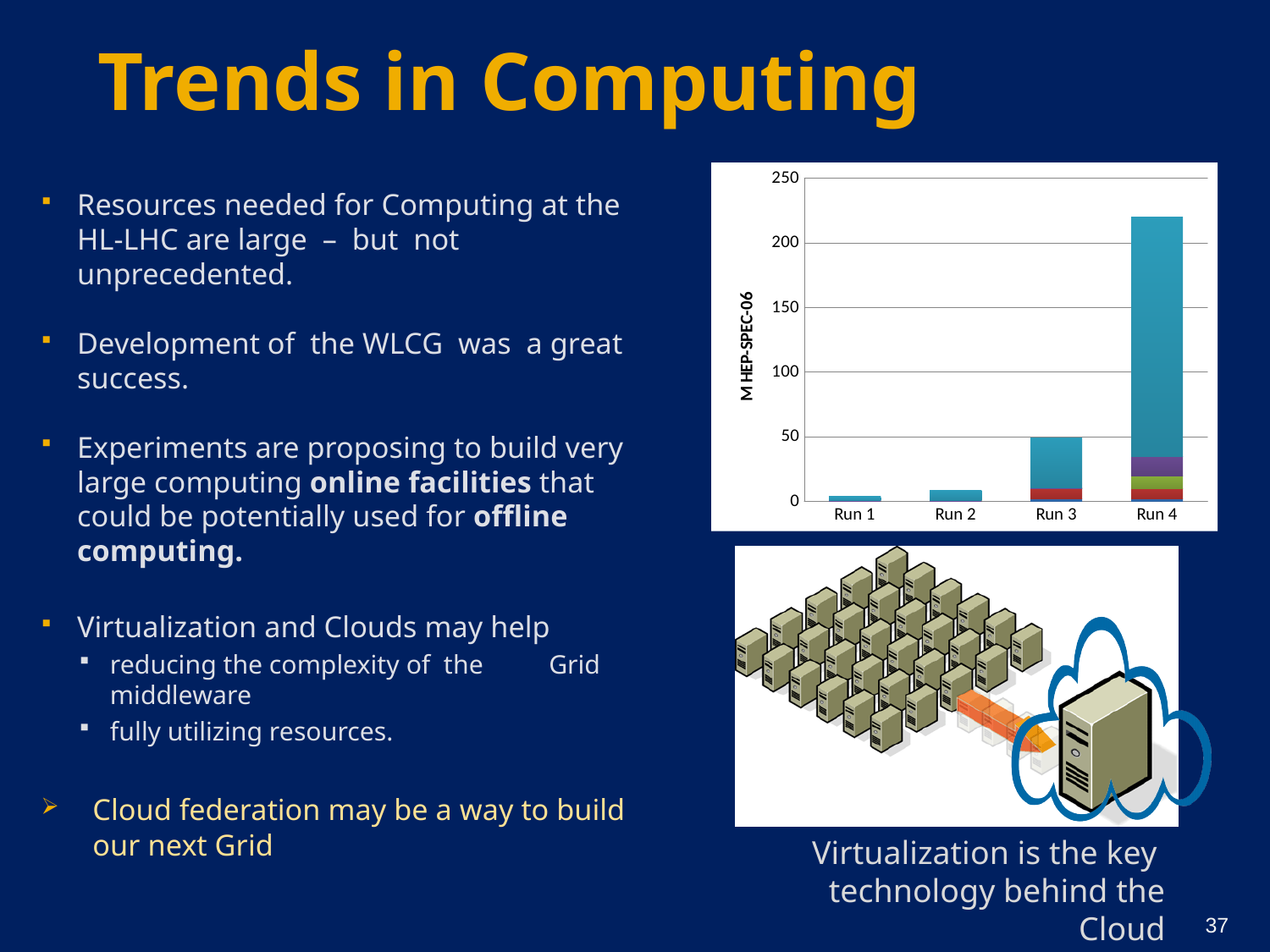
Is the total value for Run 3 greater or less than 100? less Which is larger, the total for Run 3 or the total for Run 4? Run 4 Which run has the lowest total value in the chart? Run 1 Do the total values rise or fall from Run 1 to Run 4? rise What kind of chart is shown on the slide? stacked bar chart Is the total value for Run 4 greater or less than 200? greater Which run has the highest total value in the chart? Run 4 How many categories are shown on the x axis of the chart? 4 What is the highest value shown on the y axis of the chart? 250 Is the total value for Run 1 greater or less than 50? less What is the label on the y axis of the chart? M HEP-SPEC-06